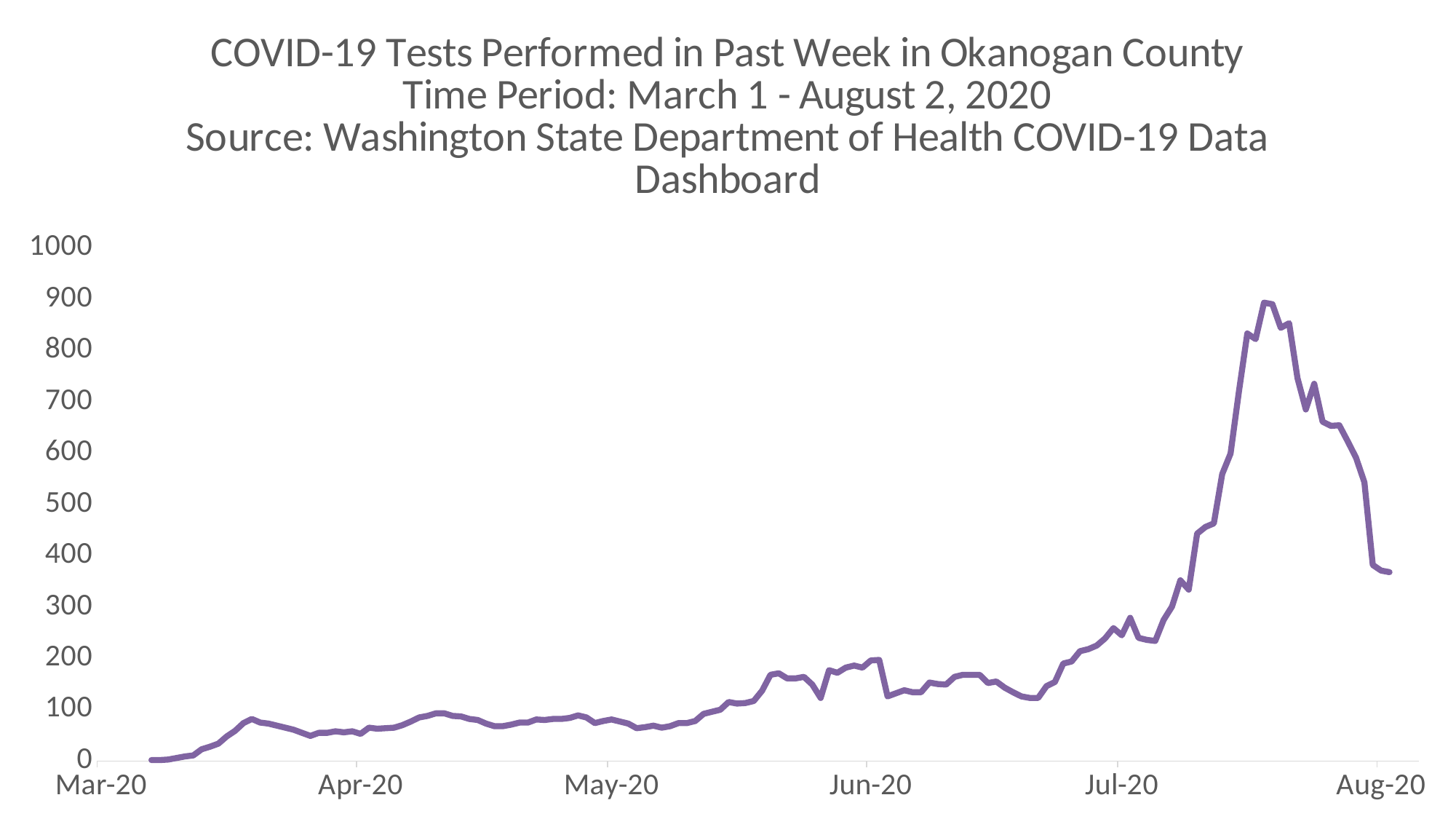
Is the value at the May-20 tick greater or less than 100? less Is the value at the Aug-20 tick greater or less than 300? greater Is the highest value on the line greater or less than 800? greater Between which two x-axis ticks does the line reach its peak? Between Jul-20 and Aug-20 What kind of chart is shown on the slide? Line chart Does the line generally rise or fall from Mar-20 to Jul-20? Rise What time period does the chart cover, according to its title? March 1 - August 2, 2020 What is the title of the chart? COVID-19 Tests Performed in Past Week in Okanogan County Time Period: March 1 - August 2, 2020 Source: Washington State Department of Health COVID-19 Data Dashboard Near which x-axis tick is the line at its lowest value? Mar-20